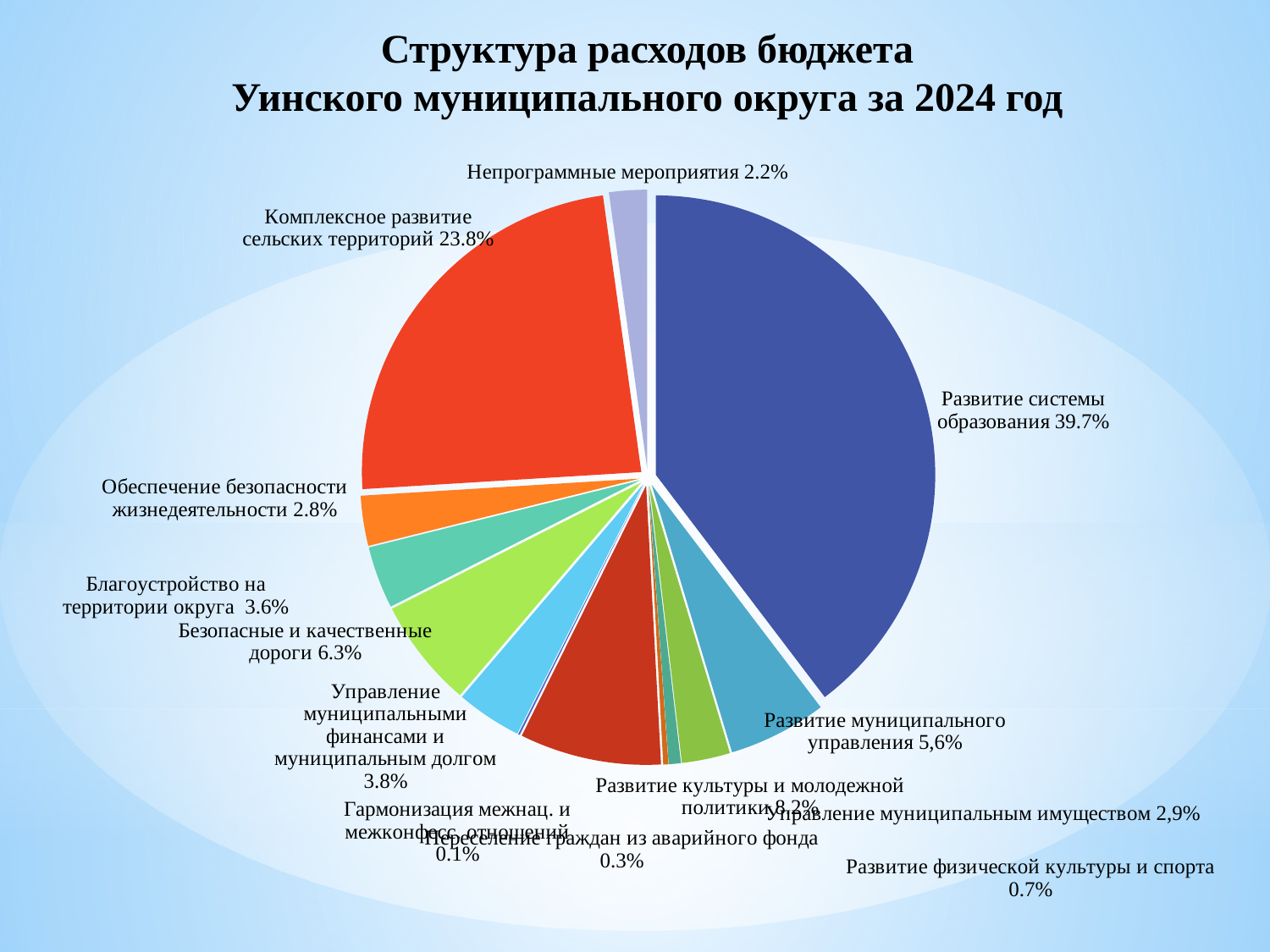
What type of chart is shown on the slide? pie chart What percentage is labelled for Развитие муниципального управления? 5,6% What is the value for Безопасные и качественные дороги? 6.3% What is the value for Непрограммные мероприятия? 2.2% What share of budget expenditure goes to Развитие системы образования? 39.7% Which category has the largest share of the pie? Развитие системы образования What year does the chart title say the budget expenditure structure refers to? 2024 Which category has the smallest share of the pie? Гармонизация межнац. и межконфесс. отношений Which is larger: Благоустройство на территории округа or Управление муниципальными финансами и муниципальным долгом? Управление муниципальными финансами и муниципальным долгом What percentage is shown for Комплексное развитие сельских территорий? 23.8% How many categories are shown in the pie chart? 13 What is the difference between the shares of Развитие системы образования and Комплексное развитие сельских территорий? 15.9%